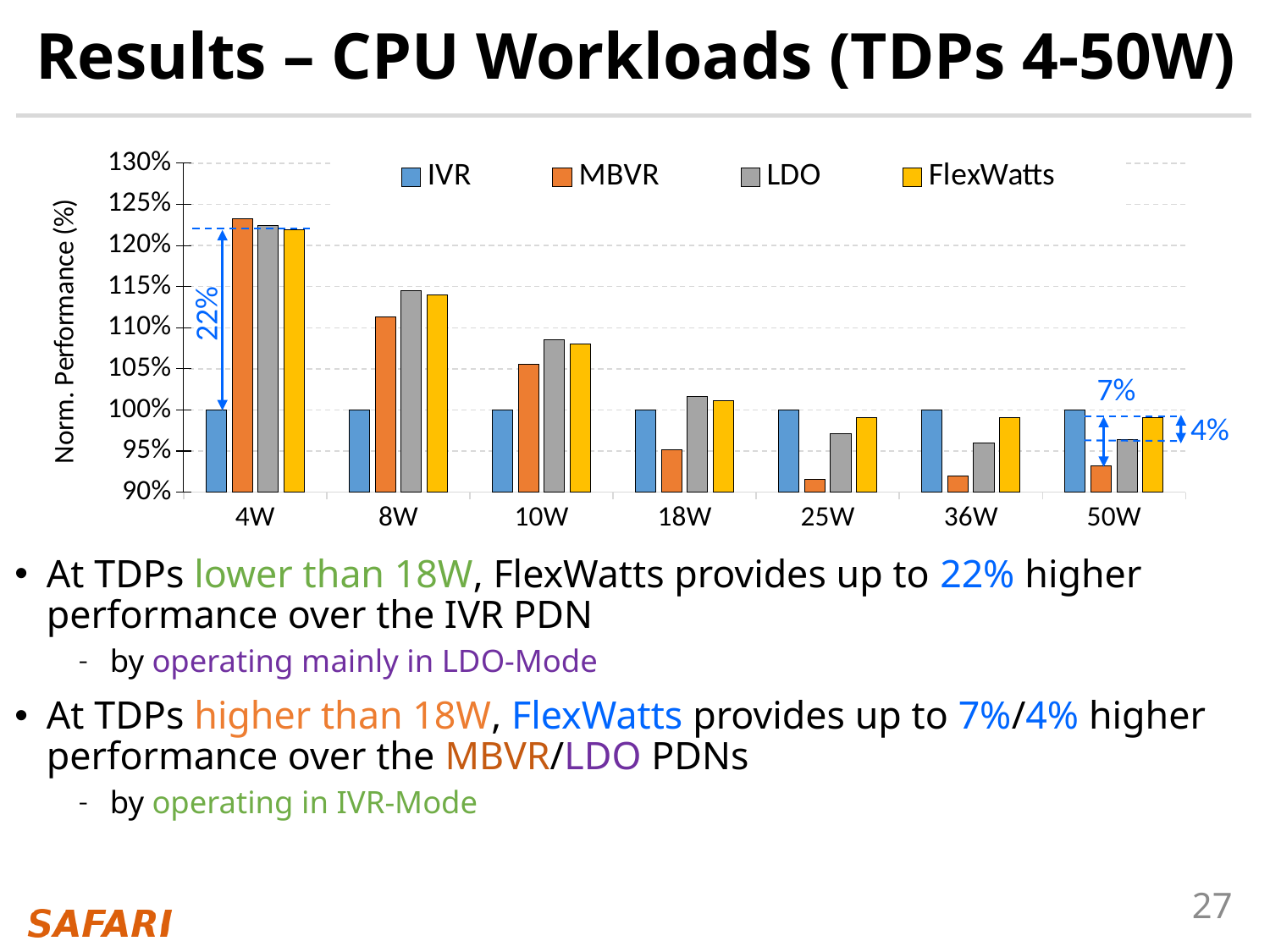
What is the label on the y axis of the chart? Norm. Performance (%) At 10W, which is larger, MBVR or LDO? LDO How many TDP categories are shown on the x axis of the chart? 7 How many series does the chart legend list? 4 What kind of chart is shown on the slide? bar chart What is the normalized performance of IVR at 50W? 100% From 4W to 18W, does the MBVR value rise or fall? fall What is the normalized performance of IVR at 4W? 100% Is the value for MBVR at 25W greater or less than 95%? less Is the value for LDO at 8W greater or less than 110%? greater Which series has the lowest value at 25W? MBVR Is the value for MBVR at 4W greater or less than 120%? greater